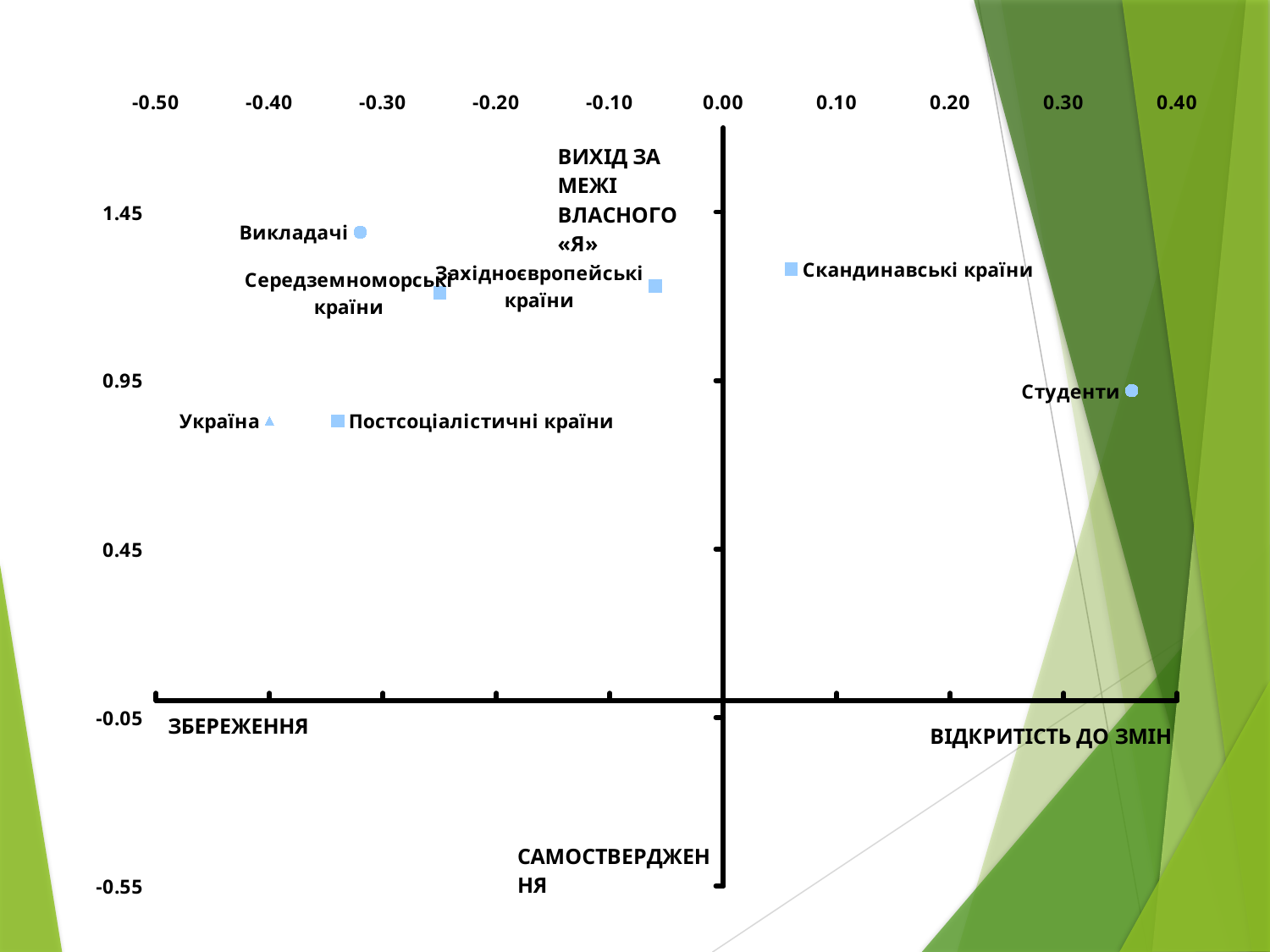
Which labelled point lies furthest to the right on the horizontal axis? Студенти Which labelled point is highest on the vertical axis? Викладачі Is the horizontal-axis value for Україна greater or less than -0.30? less What kind of chart is shown on the slide? scatter chart Which labelled point lies furthest to the left on the horizontal axis? Україна What label appears at the left end of the horizontal axis? ЗБЕРЕЖЕННЯ Is the horizontal-axis value for Студенти greater or less than 0.30? greater Which has the larger horizontal-axis value, Студенти or Викладачі? Студенти Is the vertical-axis value for Постсоціалістичні країни greater or less than 0.95? less How many labelled data points are plotted on the chart? 7 What label appears at the right end of the horizontal axis? ВІДКРИТІСТЬ ДО ЗМІН